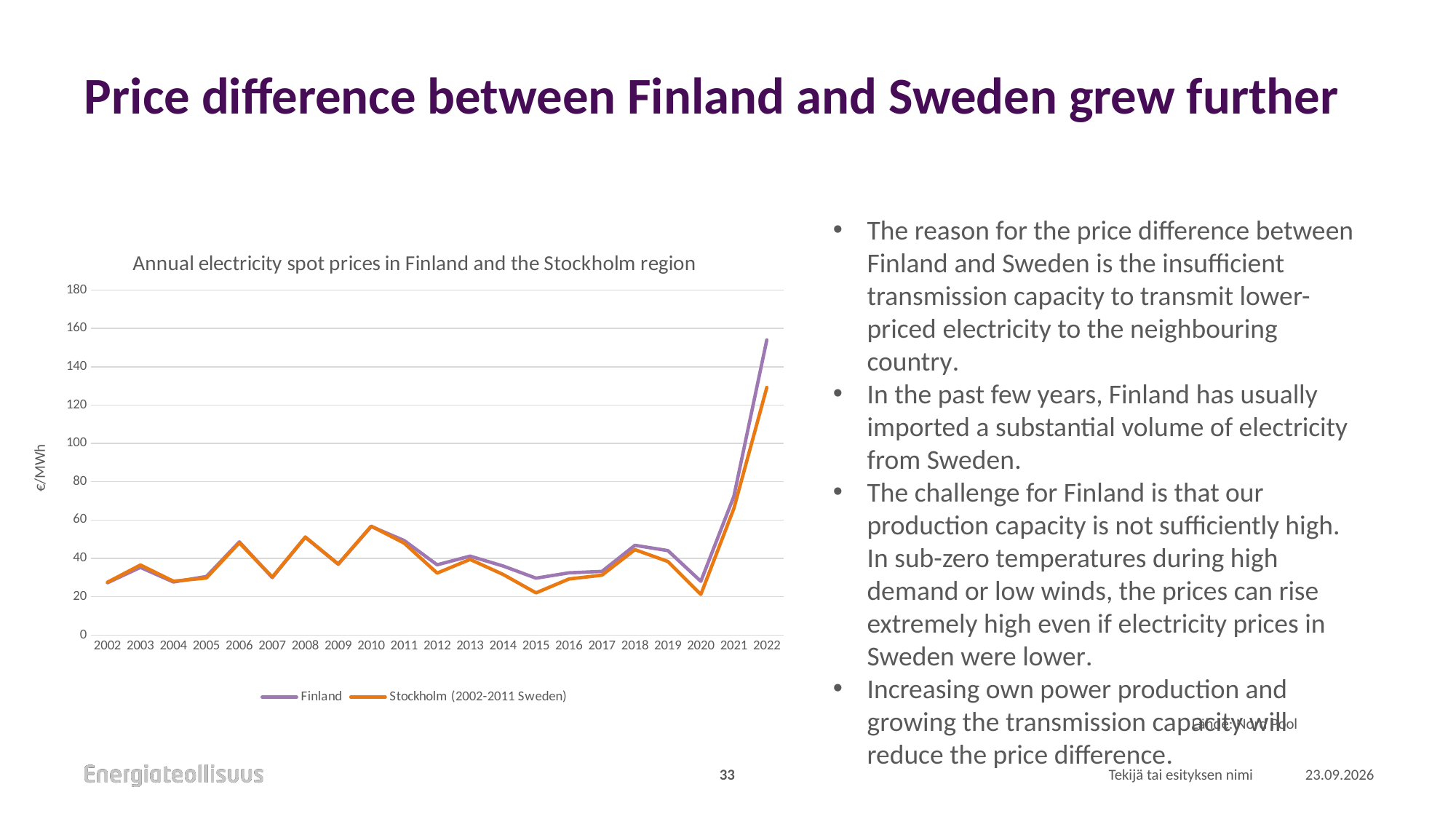
In 2022, which series has the higher value, Finland or Stockholm? Finland How many series does the chart legend list? 2 What unit is shown on the y axis of the chart? €/MWh What is the title of the chart? Annual electricity spot prices in Finland and the Stockholm region Is the value for Stockholm in 2015 greater or less than 40? less What kind of chart is shown on the slide? Line chart In which year does the Finland series reach its highest value? 2022 Is the value for Finland in 2021 greater or less than 60? greater Is the value for Finland in 2022 greater or less than 140? greater Do the plotted prices rise or fall between 2020 and 2022? Rise How many years are plotted along the x axis of the chart? 21